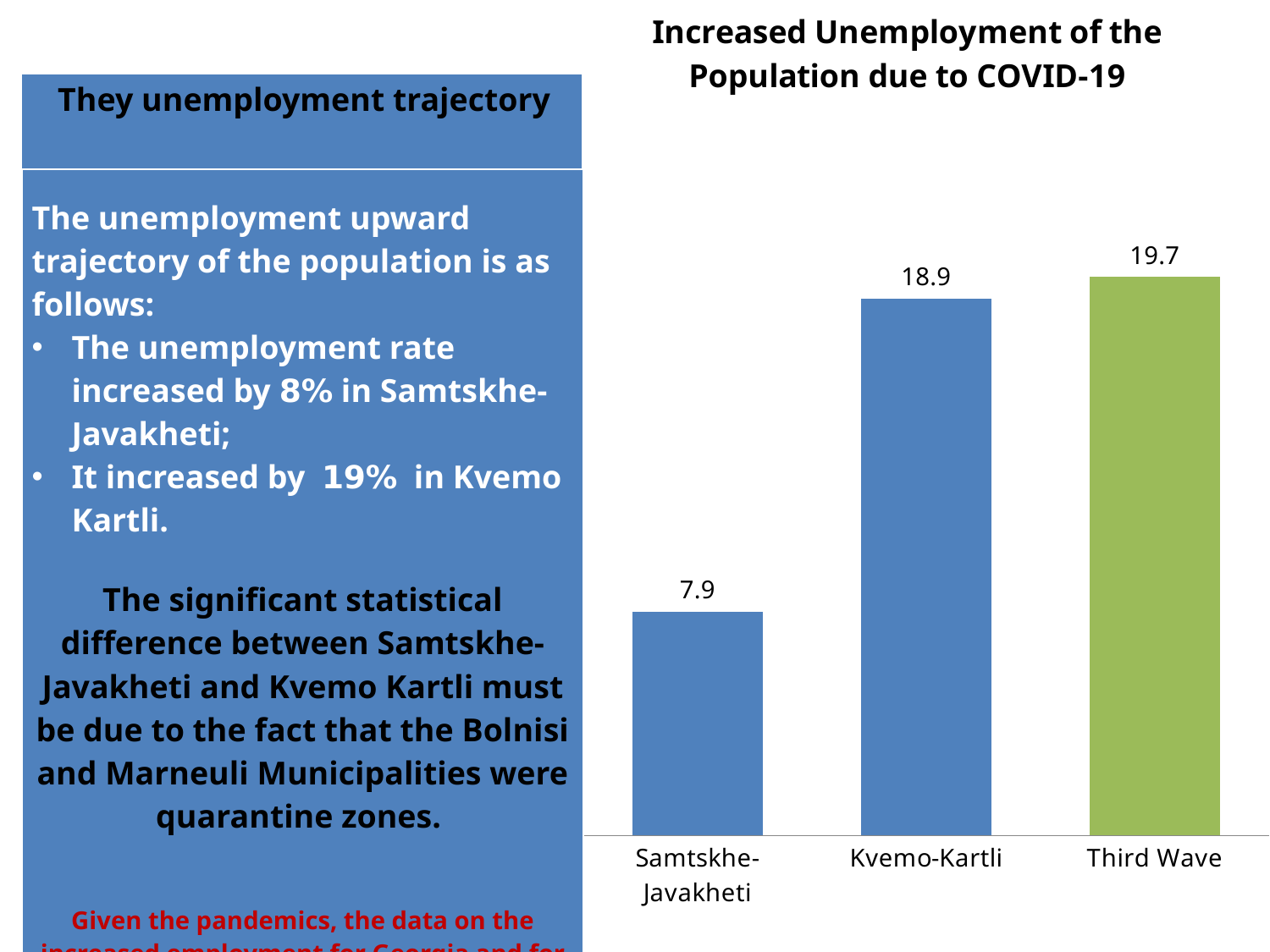
Which is larger, the value for Samtskhe-Javakheti or the value for Kvemo-Kartli? Kvemo-Kartli What is the value for Kvemo-Kartli? 18.9 Which category has the highest value? Third Wave Do the values rise or fall from left to right across the categories? rise What is the value for Samtskhe-Javakheti? 7.9 What is the difference between the values for Third Wave and Kvemo-Kartli? 0.8 What kind of chart is shown on the slide? bar chart Which category has the lowest value? Samtskhe-Javakheti What is the value for Third Wave? 19.7 What is the difference between the values for Kvemo-Kartli and Samtskhe-Javakheti? 11.0 How many categories are shown in the chart? 3 What is the title of the chart? Increased Unemployment of the Population due to COVID-19